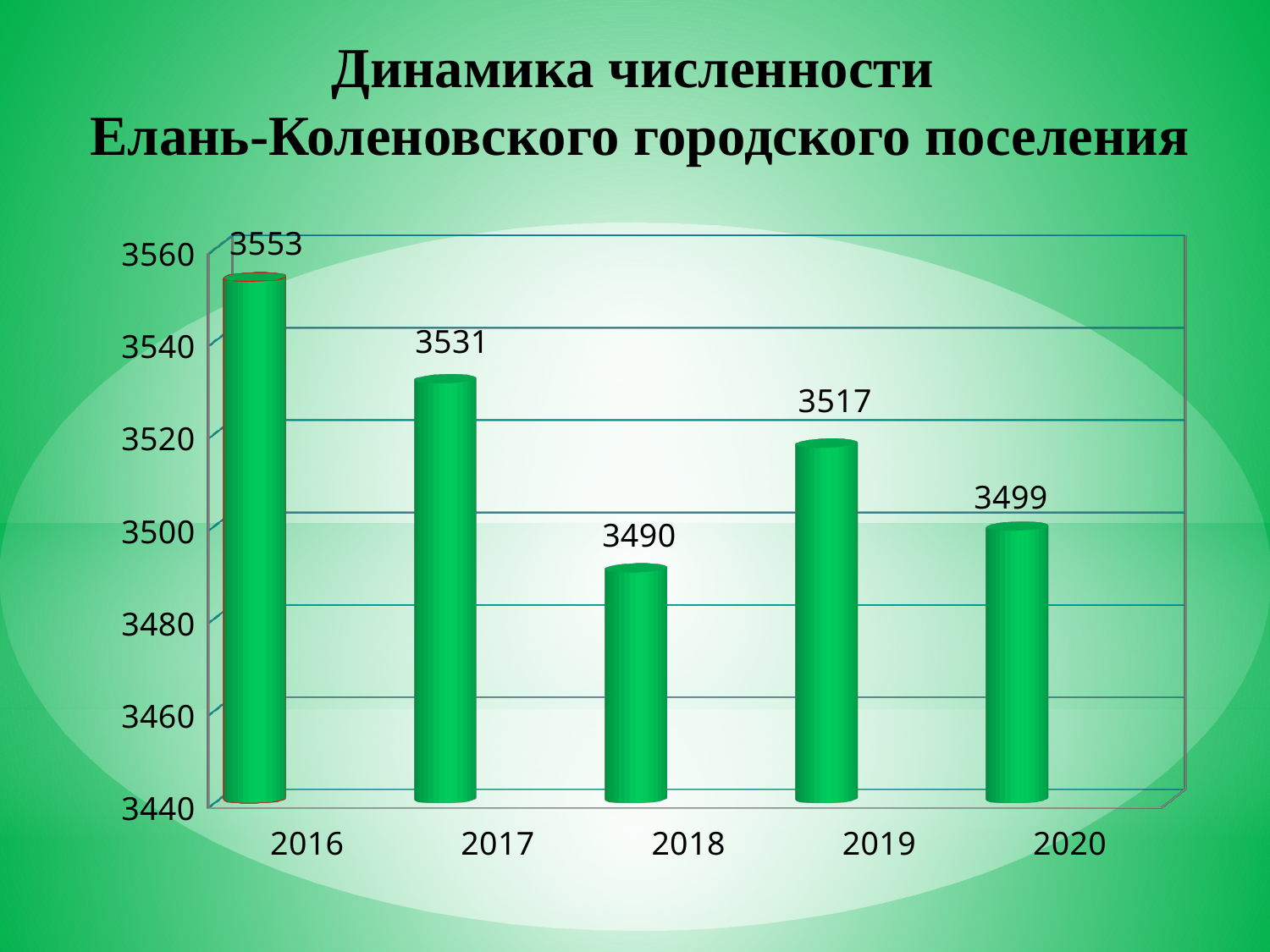
Is the value for 2017 greater or less than 3520? greater What is the value shown for 2018? 3490 What is the difference between the values for 2016 and 2020? 54 What is the title of the chart? Динамика численности Елань-Коленовского городского поселения How many years are shown on the x axis? 5 What is the population value shown for 2016? 3553 Which year has the lowest value? 2018 Which is larger, the value for 2019 or the value for 2020? 2019 What is the difference between the values for 2017 and 2018? 41 What kind of chart is shown on the slide? bar chart Which year has the highest value? 2016 What is the value shown for 2020? 3499